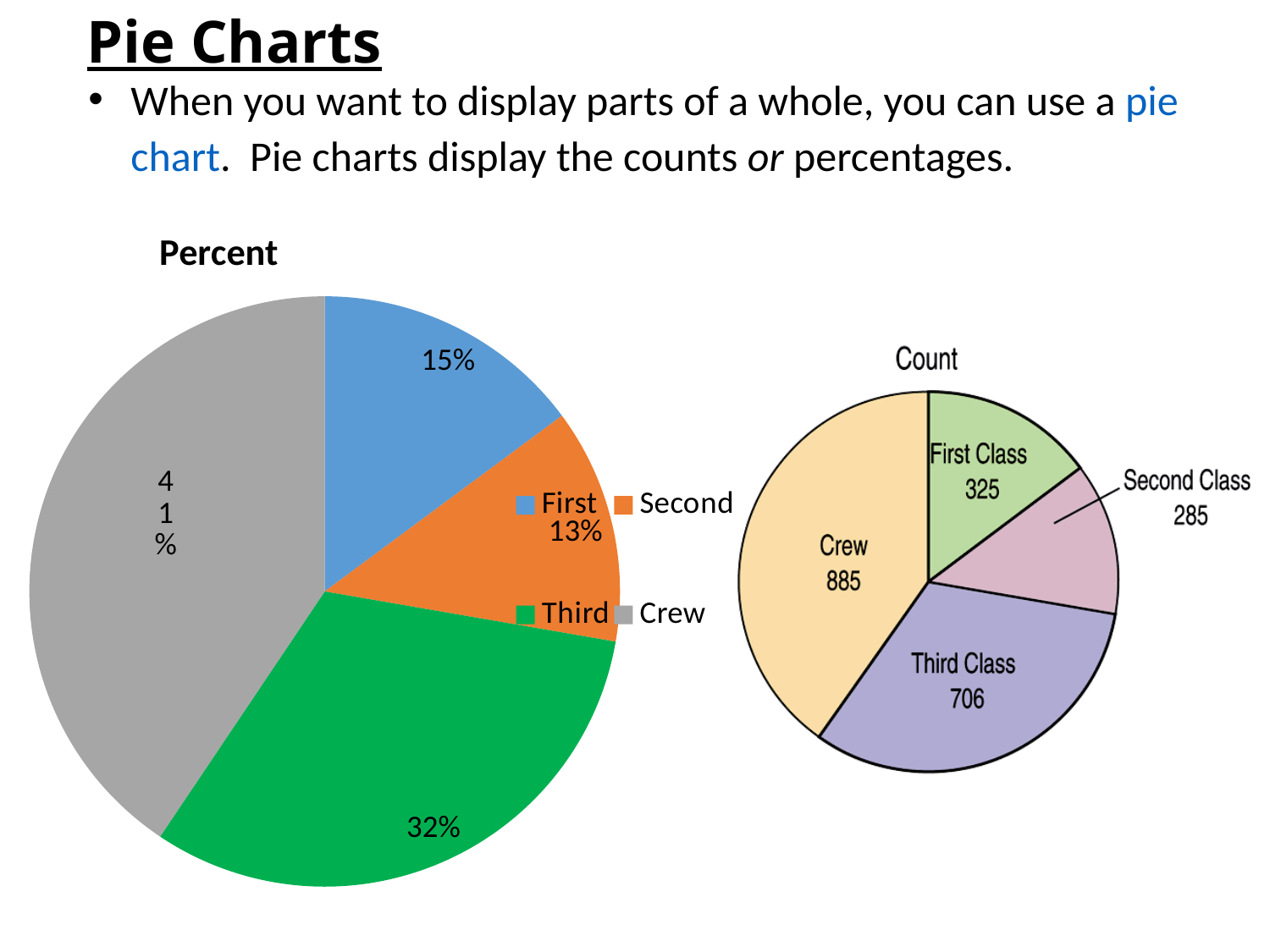
In the Percent pie chart, what percentage is shown for Third? 32% In the Count pie chart, which is larger, First Class or Second Class? First Class In the Percent pie chart, what is the difference between the Third and First percentages? 17% In the Percent pie chart, which category has the largest slice? Crew In the Count pie chart, what is the difference between the Crew and Third Class counts? 179 In the Count pie chart, what is the count for Second Class? 285 In the Count pie chart, which category has the largest count? Crew What type of chart is the chart titled Count? Pie chart In the Percent pie chart, which category has the smallest slice? Second In the Percent pie chart, what percentage is shown for Crew? 41% How many categories does the legend of the Percent pie chart list? 4 In the Count pie chart, what is the count for Crew? 885